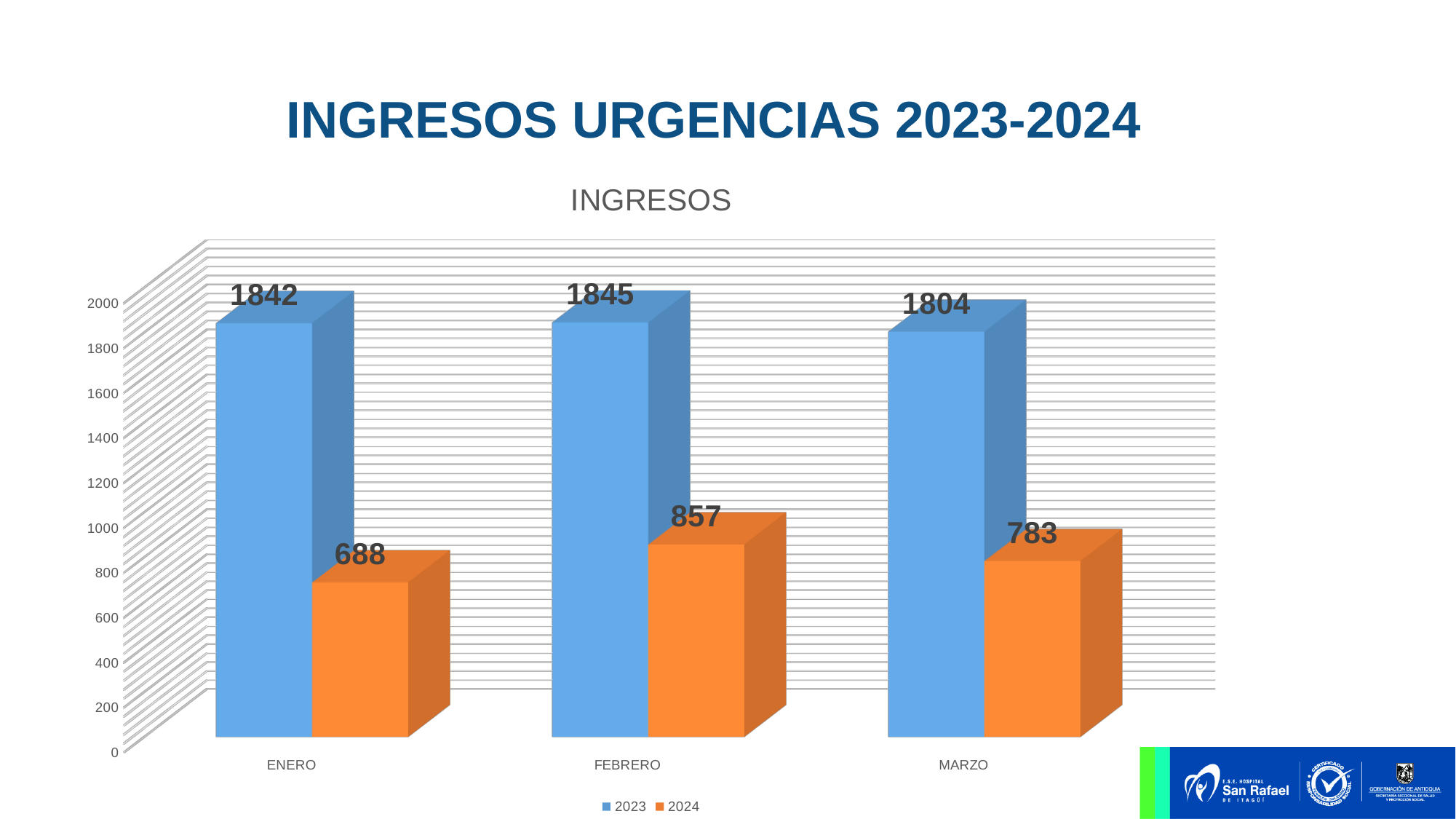
What kind of chart is shown on the slide? Bar chart What is the value for 2023 in ENERO? 1842 What is the value for 2024 in FEBRERO? 857 What is the difference between the 2024 values for FEBRERO and MARZO? 74 Which month has the highest value for the 2024 series? FEBRERO What is the value for 2024 in MARZO? 783 How many series does the legend list? 2 Which is larger in MARZO, the 2023 value or the 2024 value? 2023 Which month has the lowest value for the 2024 series? ENERO How many months are shown on the x axis? 3 Which month has the lowest value for the 2023 series? MARZO What is the difference between the 2023 and 2024 values in ENERO? 1154